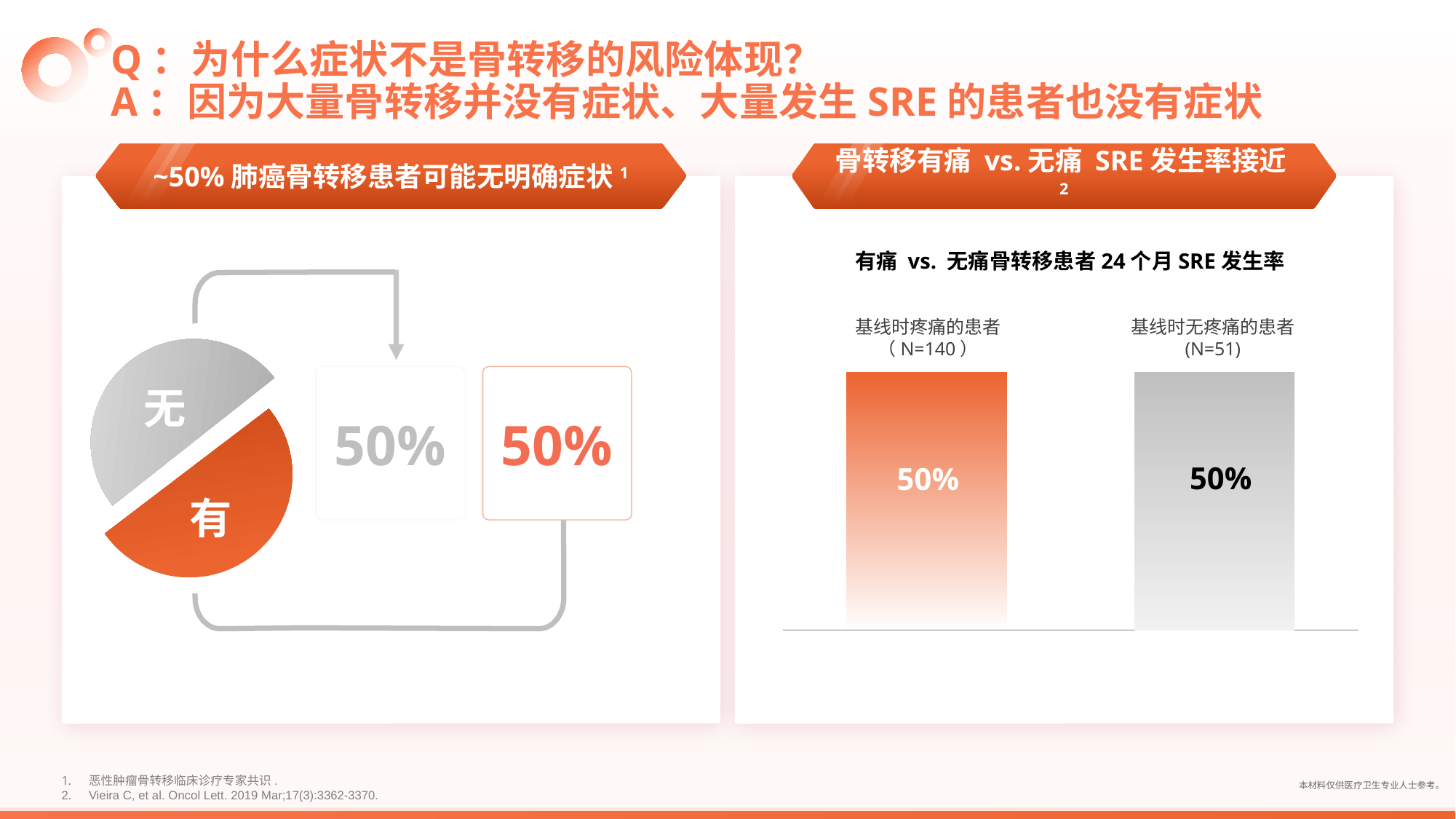
What kind of chart is shown on the left side of the slide? Pie chart In the bar chart on the right, how many patients are in the group without pain at baseline (N)? 51 What is the title of the chart on the right side of the slide? 有痛 vs. 无痛骨转移患者 24 个月 SRE 发生率 In the bar chart on the right, how many patients are in the group with pain at baseline (N)? 140 In the bar chart on the right, what is the 24-month SRE incidence for patients without pain at baseline (基线时无疼痛的患者)? 50% How many bars are shown in the bar chart on the right? 2 In the pie chart on the left, what colour is the 有 slice? Orange In the pie chart on the left, what share of patients is in the 无 (no symptoms) slice? 50% In the bar chart on the right, what is the 24-month SRE incidence for patients with pain at baseline (基线时疼痛的患者)? 50% In the bar chart on the right, what is the difference between the SRE incidence for patients with pain and patients without pain? 0% In the pie chart on the left, what share of patients is in the 有 (symptoms) slice? 50% What kind of chart is shown on the right side of the slide? Bar chart